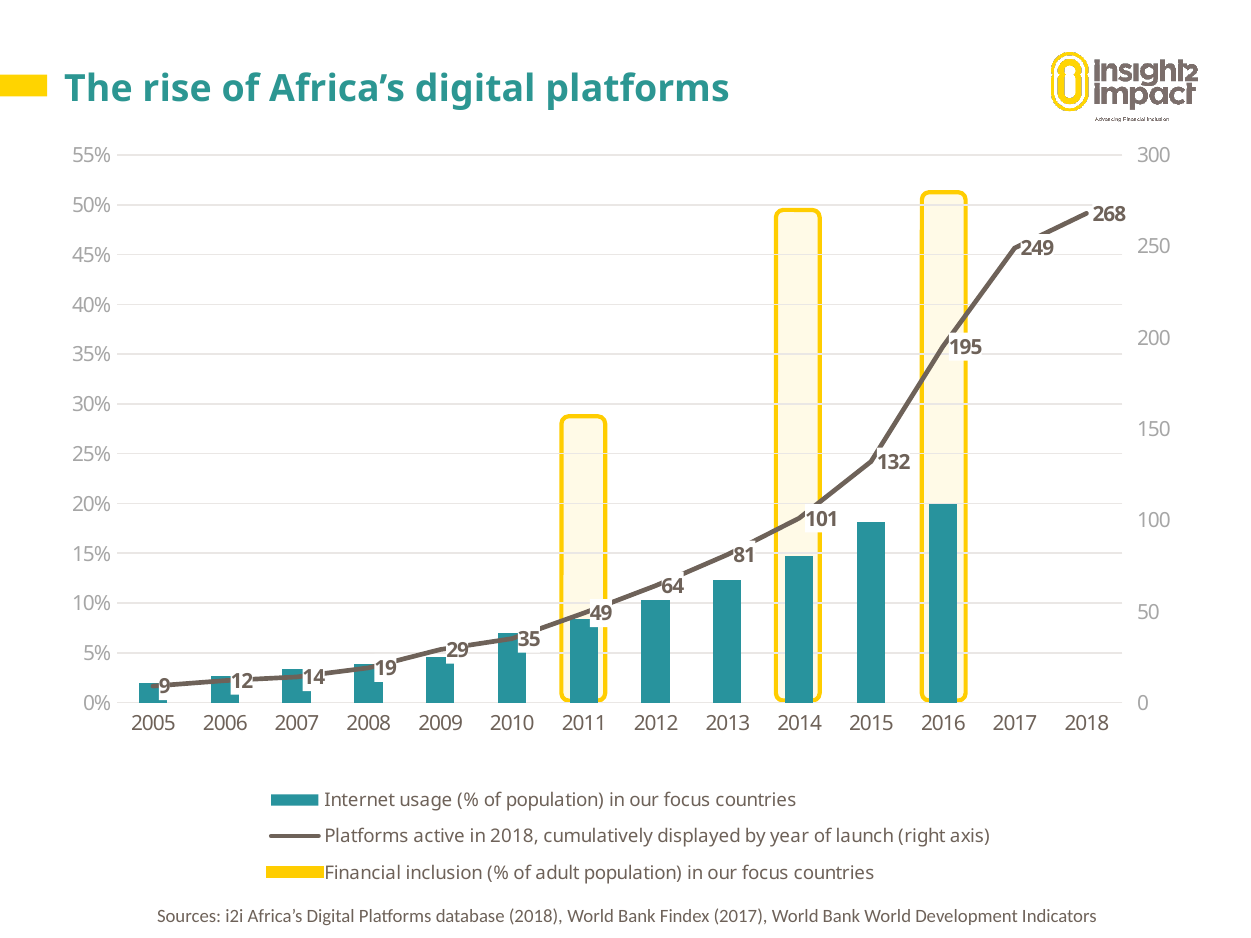
By how much does the platforms value increase from 2017 to 2018? 19 Is the internet usage bar for 2012 greater or less than 15%? less What is the value of platforms active in 2018 shown for the year 2014? 101 What is the difference between the platforms values for 2016 and 2015? 63 What is the value of platforms active in 2018 shown for the year 2011? 49 How many series does the legend list? 3 How many years are shown on the x axis? 14 Does the platforms line rise or fall from 2005 to 2018? rise In which year is the platforms line at its lowest value? 2005 Which year has the higher internet usage bar, 2013 or 2015? 2015 Is the internet usage bar for 2016 greater or less than 15%? greater What is the value of platforms active in 2018 shown for the year 2018? 268